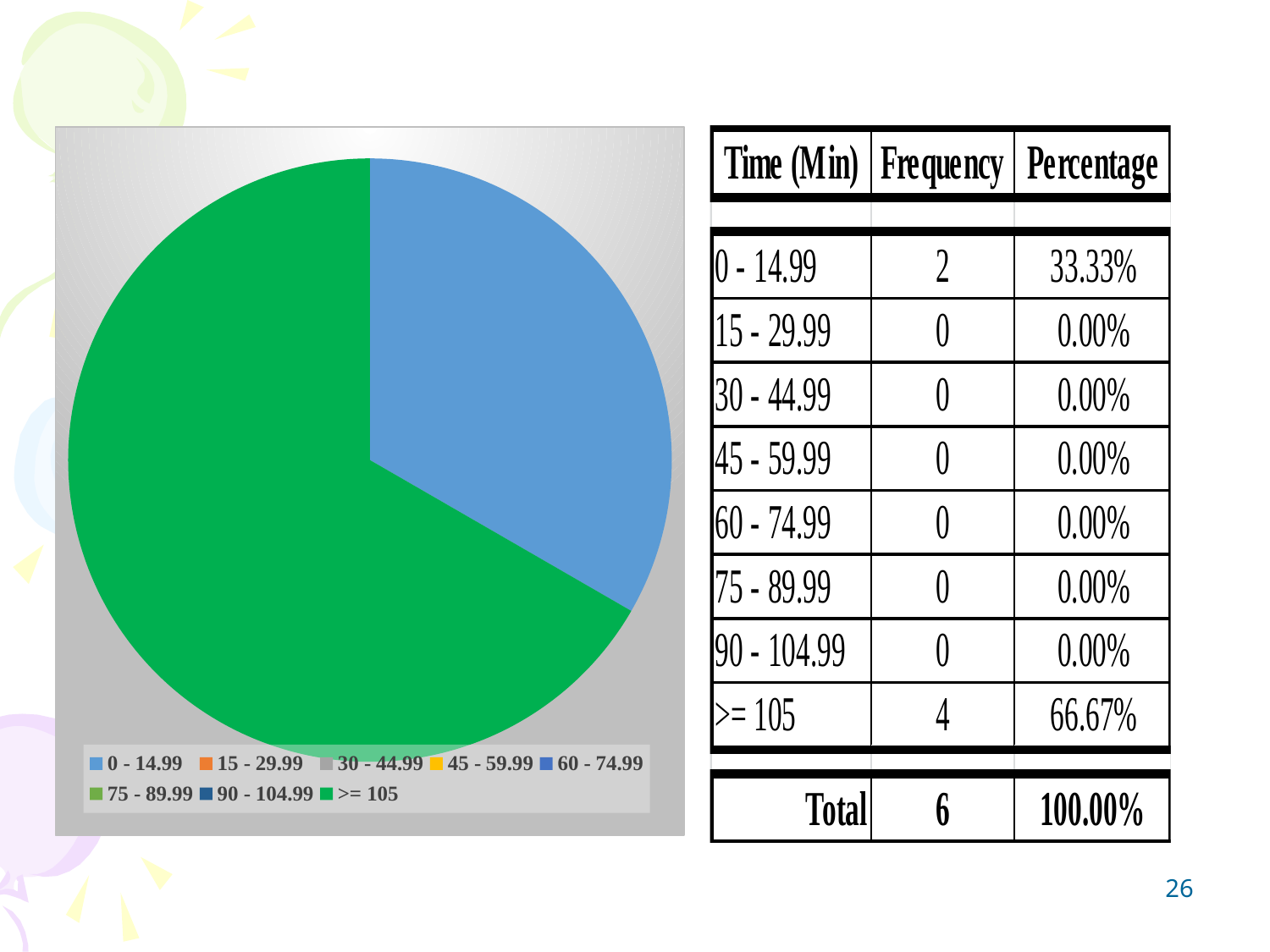
According to the table, what is the frequency for the >= 105 category? 4 What colour is the 0 - 14.99 slice in the pie chart? blue What is the total frequency shown in the table? 6 What share of the pie does the 0 - 14.99 slice represent, as given in the table? 33.33% What is the difference in frequency between the >= 105 and 0 - 14.99 categories? 2 What colour is the >= 105 slice in the pie chart? green What kind of chart is shown on the left of the slide? pie chart Which of the two visible slices is larger, 0 - 14.99 or >= 105? >= 105 What share of the pie does the >= 105 slice represent, as given in the table? 66.67% According to the table, what is the frequency for the 0 - 14.99 category? 2 Which category has the largest slice in the pie chart? >= 105 How many categories does the pie chart's legend list? 8